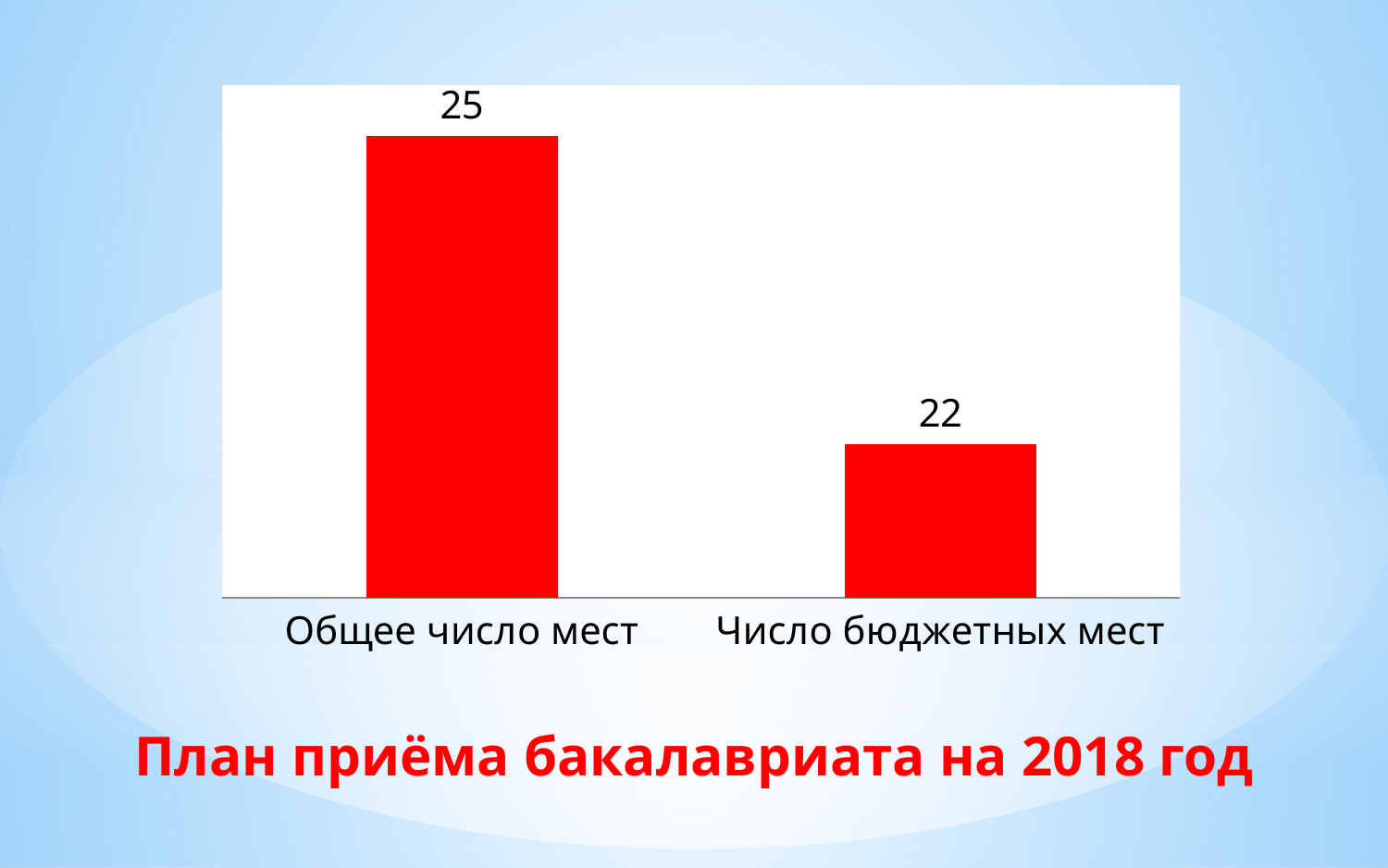
What is the value for Число бюджетных мест? 22 Which is larger, Общее число мест or Число бюджетных мест? Общее число мест How many categories are shown in the chart? 2 What colour are the bars in the chart? Red What is the difference between Общее число мест and Число бюджетных мест? 3 What is the value for Общее число мест? 25 Which category has the highest value? Общее число мест Which category has the lowest value? Число бюджетных мест What kind of chart is shown on the slide? Bar chart What is the title text shown below the chart? План приёма бакалавриата на 2018 год